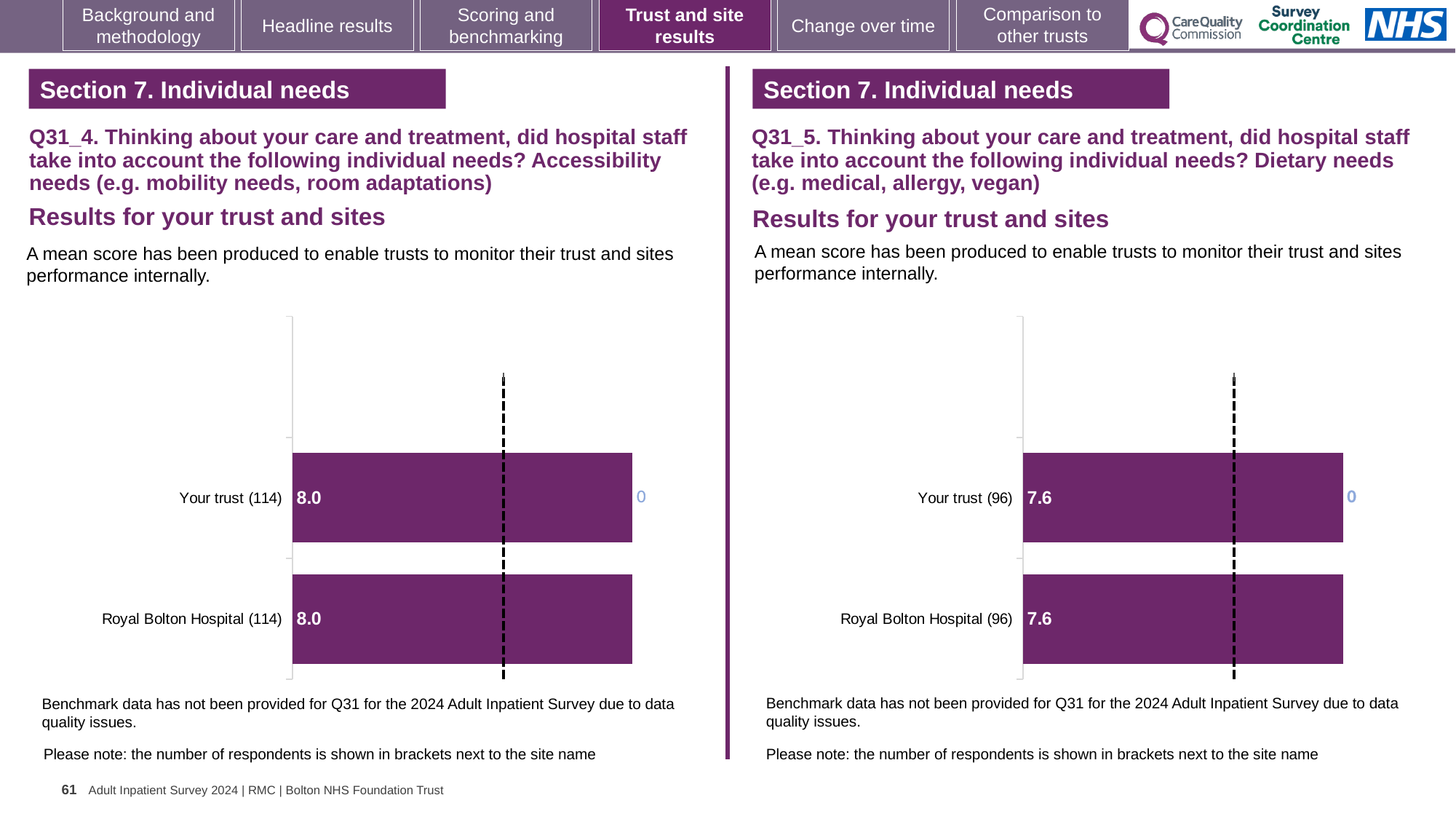
How many bars are plotted in the right chart (Q31_5, Dietary needs)? 2 In the right chart (Q31_5, Dietary needs), what is the mean score for Royal Bolton Hospital? 7.6 What type of chart is used in the right chart (Q31_5, Dietary needs)? Bar chart In the left chart (Q31_4, Accessibility needs), how many respondents are shown in brackets for Your trust? 114 Which is larger: the Your trust score in the left chart (Q31_4) or the Your trust score in the right chart (Q31_5)? Left chart (Q31_4), 8.0 In the right chart (Q31_5, Dietary needs), what is the difference between the scores for Your trust and Royal Bolton Hospital? 0.0 In the right chart (Q31_5, Dietary needs), what is the mean score for Your trust? 7.6 In the right chart (Q31_5, Dietary needs), how many respondents are shown in brackets for Royal Bolton Hospital? 96 In the left chart (Q31_4, Accessibility needs), what is the difference between the scores for Your trust and Royal Bolton Hospital? 0.0 In the left chart (Q31_4, Accessibility needs), what is the mean score for Royal Bolton Hospital? 8.0 In the left chart (Q31_4, Accessibility needs), what is the mean score for Your trust? 8.0 How many bars are plotted in the left chart (Q31_4, Accessibility needs)? 2